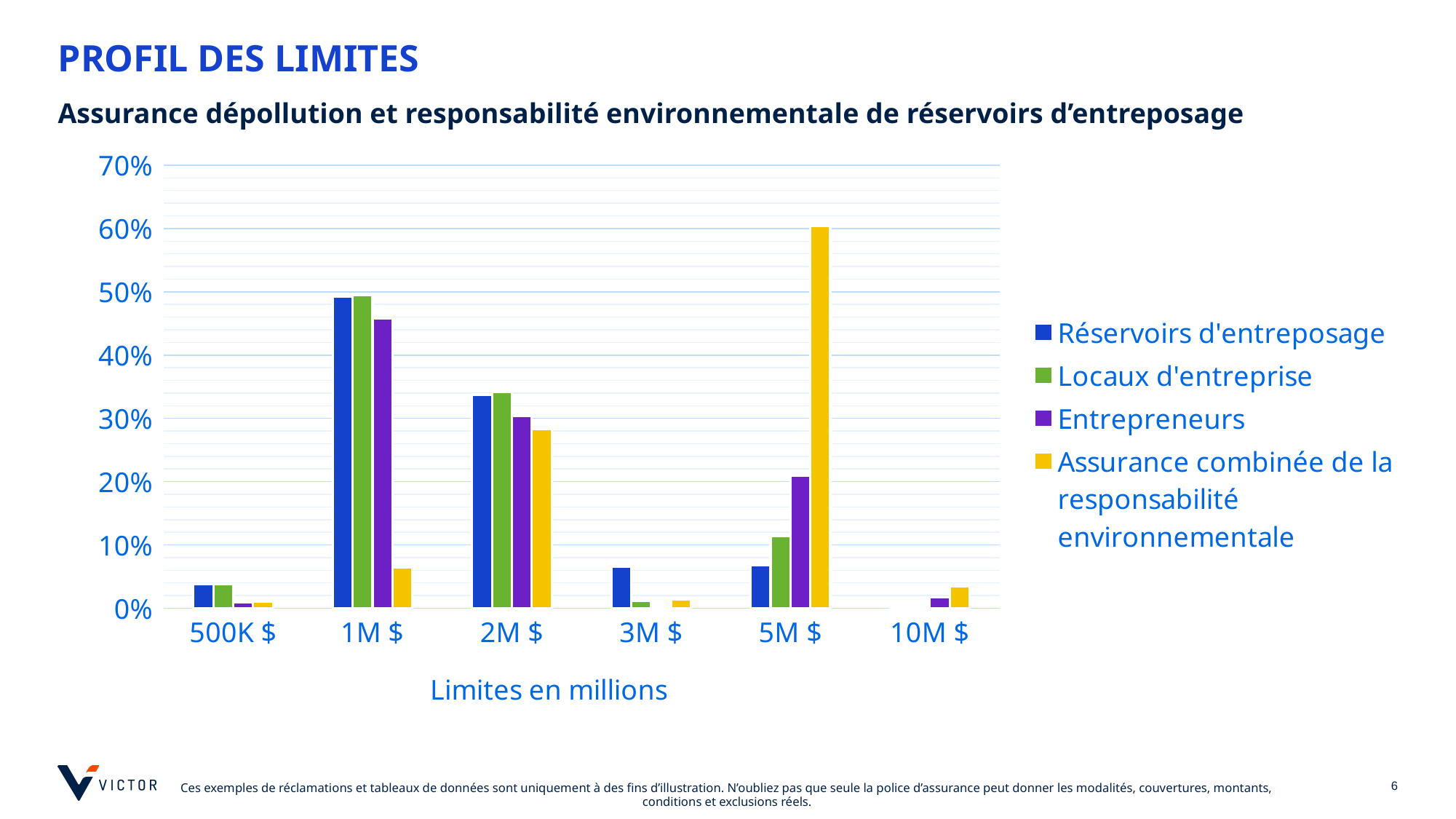
Is the value for Réservoirs d'entreposage at 2M $ greater or less than 30%? greater Is the value for Assurance combinée de la responsabilité environnementale at 5M $ greater or less than 50%? greater What kind of chart is shown on the slide? Bar chart Is the value for Entrepreneurs at 1M $ greater or less than 40%? greater For the series Réservoirs d'entreposage, which limit has the highest value? 1M $ At 2M $, which is larger: Réservoirs d'entreposage or Assurance combinée de la responsabilité environnementale? Réservoirs d'entreposage How many limit categories are shown on the x axis? 6 What is the title of the x axis? Limites en millions At 5M $, which is larger: Entrepreneurs or Locaux d'entreprise? Entrepreneurs How many series does the legend list? 4 For the series Assurance combinée de la responsabilité environnementale, which limit has the highest value? 5M $